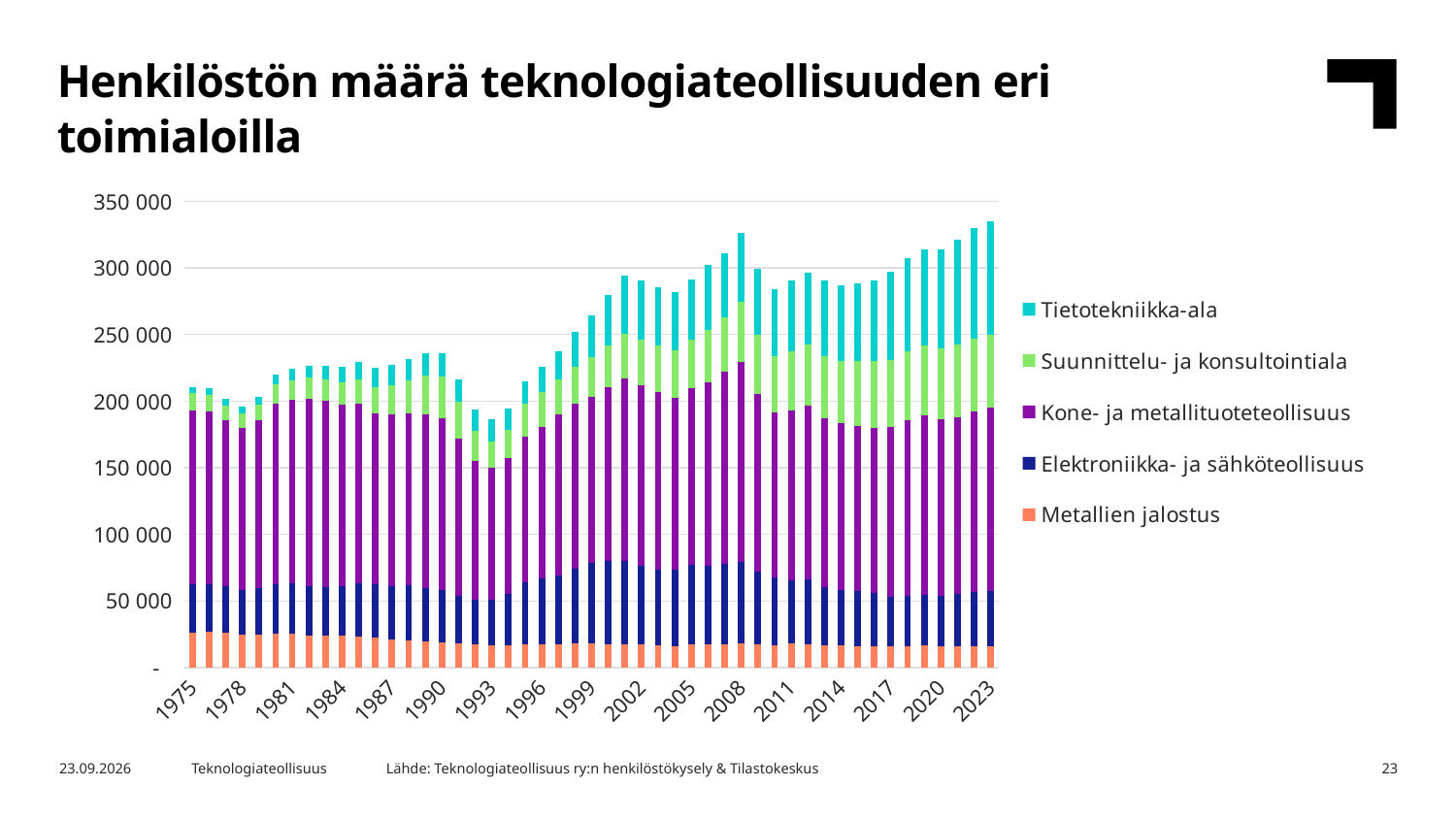
Which year has the lowest total stacked bar? 1993 What kind of chart is shown on the slide? Stacked bar chart How many series does the legend list? 5 Which year has the highest total stacked bar? 2023 Is the value for Metallien jalostus in 1975 greater or less than 50 000? less What is the title of the chart? Henkilöstön määrä teknologiateollisuuden eri toimialoilla Is the total value of the stacked bar for 2008 greater or less than 300 000? greater Which series is shown at the top of each stacked bar, according to the legend? Tietotekniikka-ala Is the total value of the stacked bar for 1993 greater or less than 200 000? less Which has the larger total stacked bar, 2008 or 2011? 2008 Do the total stacked bar values rise or fall from 1990 to 1993? fall